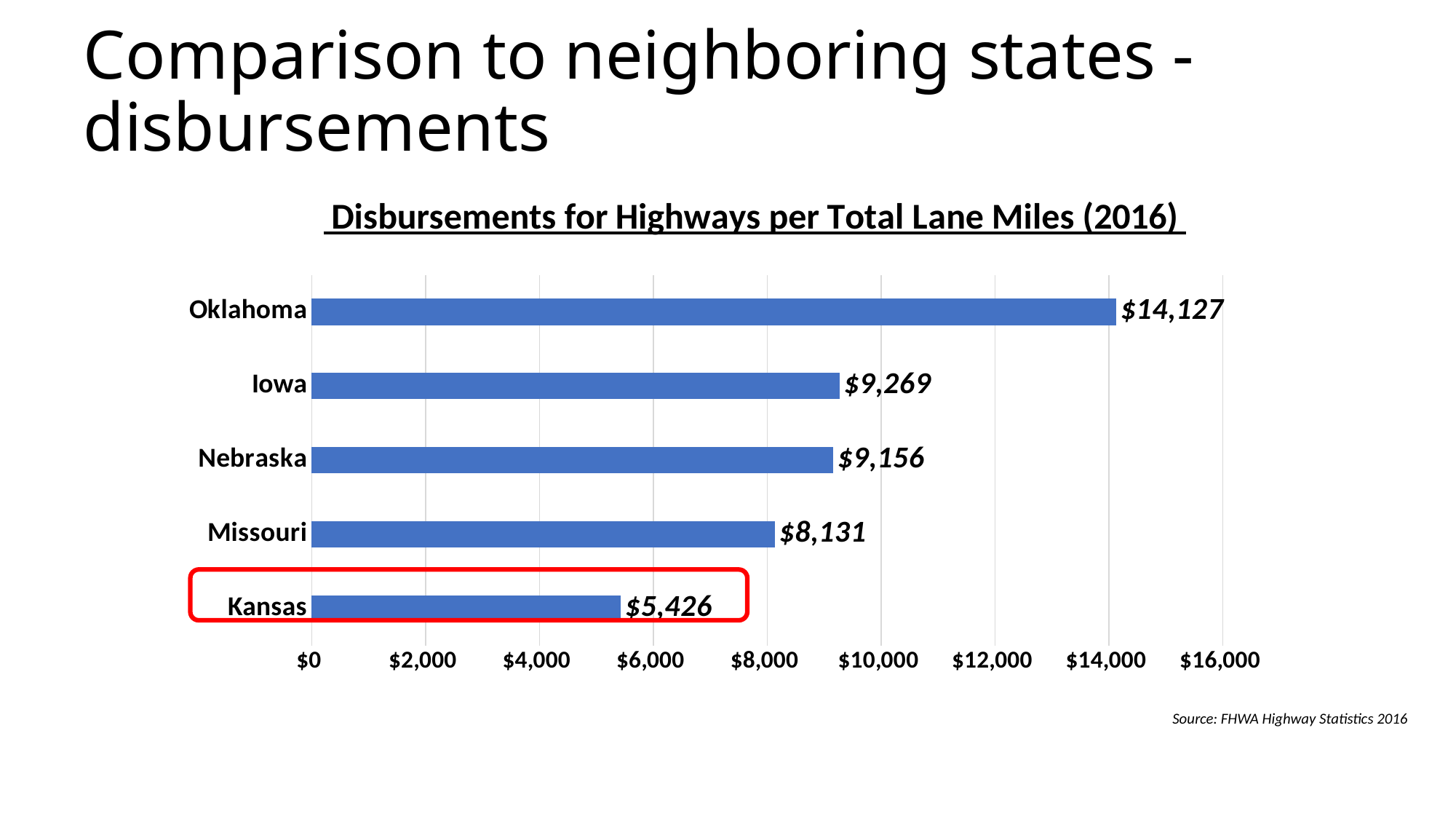
Which state has the lowest disbursements per total lane miles? Kansas What is the value for Kansas? $5,426 What is the difference between the values for Oklahoma and Kansas? $8,701 Which is larger, the value for Missouri or the value for Nebraska? Nebraska Is the value for Iowa greater or less than $8,000? greater What is the difference between the values for Iowa and Nebraska? $113 Which state has the highest disbursements per total lane miles? Oklahoma How many states are shown in the chart? 5 What is the value for Missouri? $8,131 What is the value for Oklahoma? $14,127 What is the title of the chart? Disbursements for Highways per Total Lane Miles (2016) What kind of chart is shown on the slide? bar chart